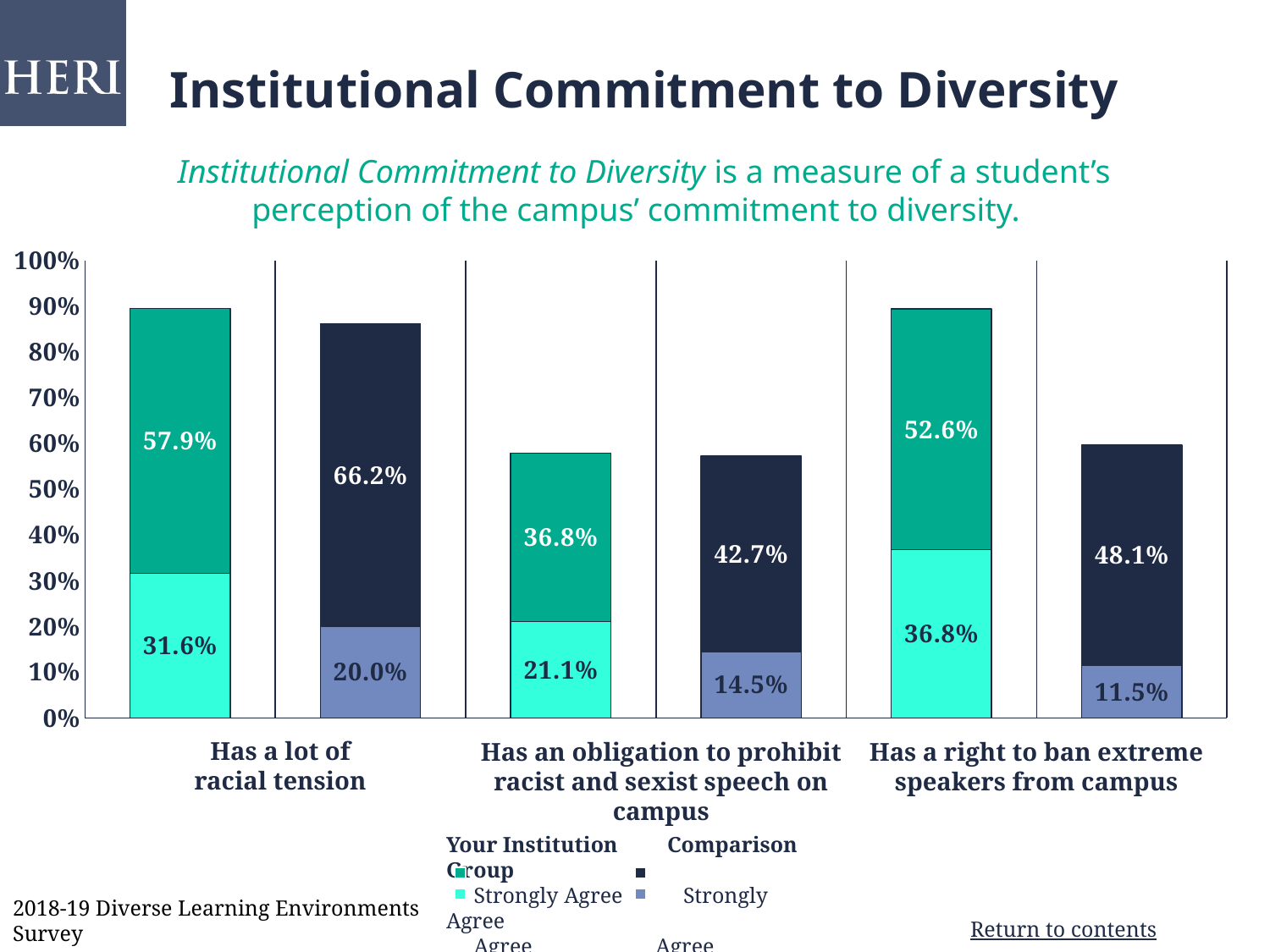
What kind of chart is shown on the slide? Stacked bar chart What is the difference between Your Institution's and the Comparison Group's 'Strongly Agree' values for 'Has a right to ban extreme speakers from campus'? 25.3 percentage points What is the Comparison Group's 'Strongly Agree' value for 'Has a right to ban extreme speakers from campus'? 11.5% What is the total height of the Your Institution stacked bar for 'Has a lot of racial tension'? 89.5% Which is larger: the Comparison Group's 'Agree' value for 'Has a lot of racial tension' or for 'Has a right to ban extreme speakers from campus'? Has a lot of racial tension (66.2%) What percentage of students at Your Institution strongly agree that the campus has a lot of racial tension? 31.6% What is the total height of the Comparison Group stacked bar for 'Has a right to ban extreme speakers from campus'? 59.6% What is Your Institution's 'Agree' value for 'Has an obligation to prohibit racist and sexist speech on campus'? 36.8% Among the Comparison Group's 'Strongly Agree' values, which category is lowest? Has a right to ban extreme speakers from campus How many categories are shown on the x axis of the chart? 3 What is the Comparison Group's 'Agree' value for 'Has a lot of racial tension'? 66.2% How many series does the legend list? 4